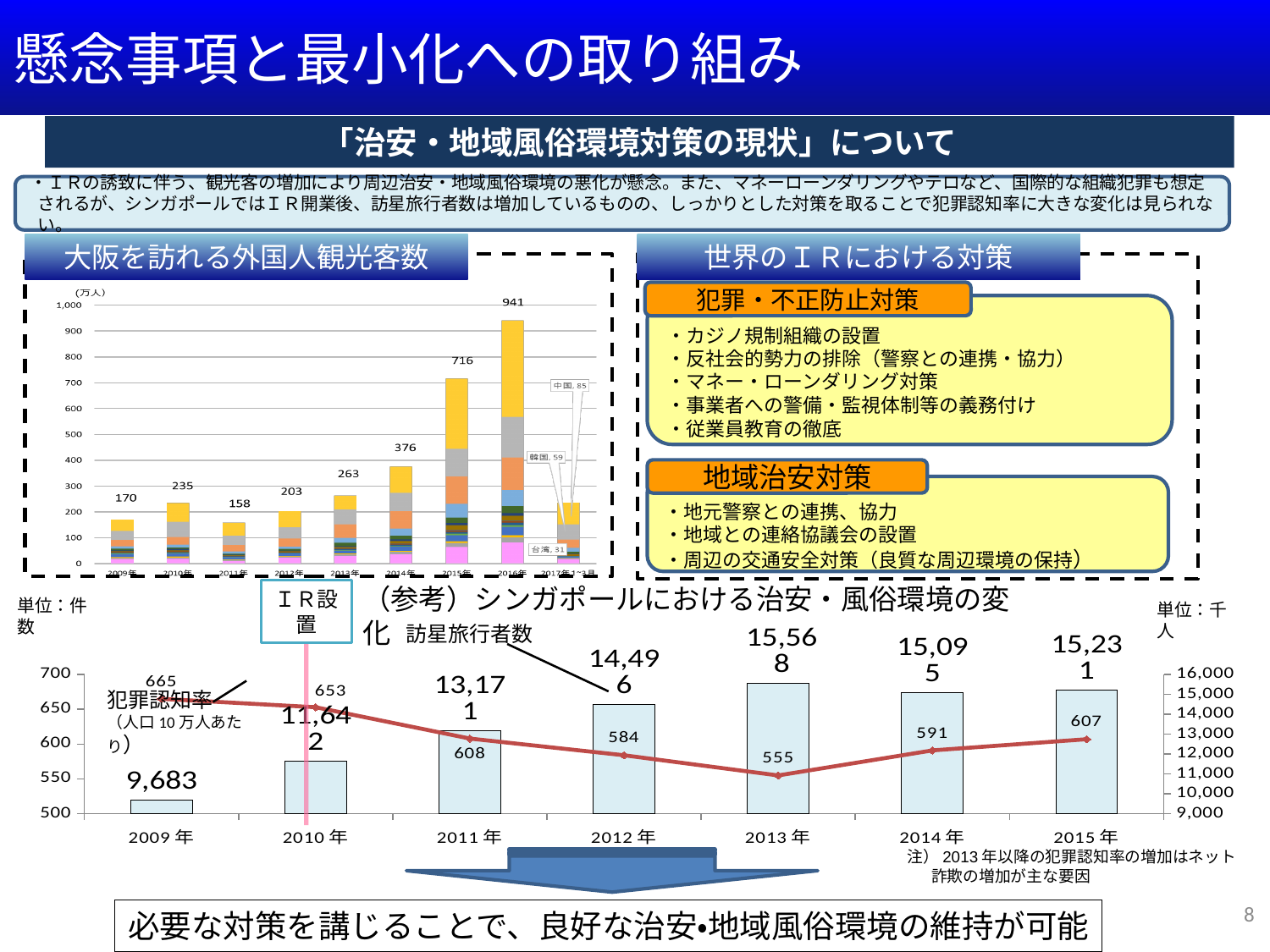
In the chart titled 大阪を訪れる外国人観光客数, what kind of chart is used? stacked bar chart In the bottom chart (シンガポールにおける治安・風俗環境の変化), which year has the highest 訪星旅行者数? 2013年 In the chart titled 大阪を訪れる外国人観光客数, what is the difference between the labelled totals for 2016年 and 2015年? 225 In the chart titled 大阪を訪れる外国人観光客数, what is the total value labelled for 2016年? 941 In the bottom chart (シンガポールにおける治安・風俗環境の変化), in which year is the 犯罪認知率 lowest? 2013年 In the bottom chart (シンガポールにおける治安・風俗環境の変化), what is the 犯罪認知率 value for 2009年? 665 In the chart titled 大阪を訪れる外国人観光客数, what is the value labelled for 中国 in the 2017年1~3月 bar? 85 In the bottom chart (シンガポールにおける治安・風俗環境の変化), what is the difference in 訪星旅行者数 between 2010年 and 2009年? 1,959 In the chart titled 大阪を訪れる外国人観光客数, what is the total value labelled for 2009年? 170 In the chart titled 大阪を訪れる外国人観光客数, which year has the lowest labelled total? 2011年 In the bottom chart (シンガポールにおける治安・風俗環境の変化), what is the 訪星旅行者数 value for 2013年? 15,568 In the bottom chart (シンガポールにおける治安・風俗環境の変化), how many years are shown on the x axis? 7